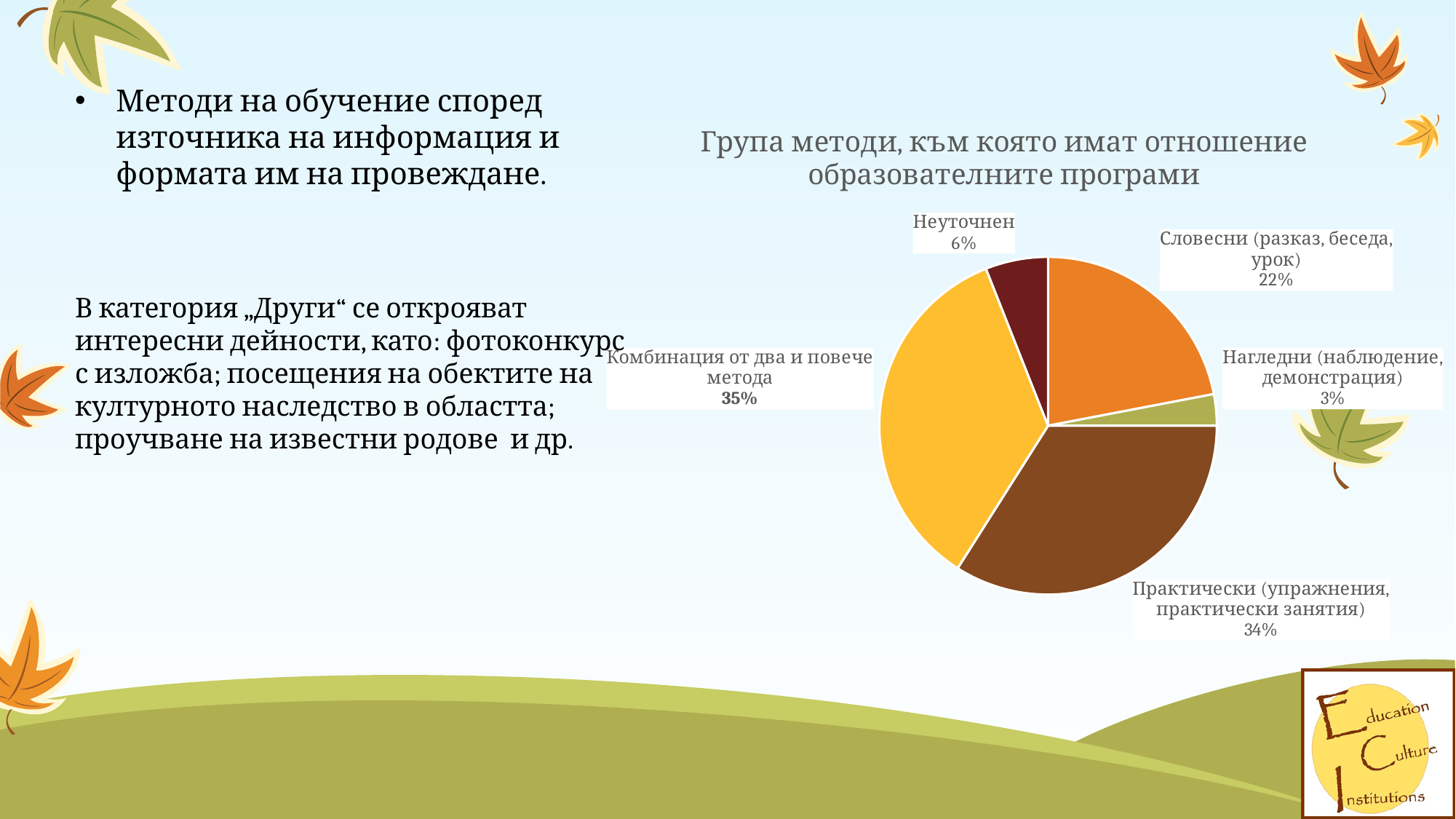
How many slices does the pie chart have? 5 What is the title of the chart? Група методи, към която имат отношение образователните програми What share of the pie is "Комбинация от два и повече метода"? 35% What share of the pie is "Нагледни (наблюдение, демонстрация)"? 3% What share of the pie is "Практически (упражнения, практически занятия)"? 34% Which category has the smallest share of the pie? Нагледни (наблюдение, демонстрация) Which is larger: the share for "Словесни (разказ, беседа, урок)" or the share for "Нагледни (наблюдение, демонстрация)"? Словесни (разказ, беседа, урок) Which category has the largest share of the pie? Комбинация от два и повече метода What type of chart is shown on the slide? Pie chart What is the difference in percentage points between "Словесни (разказ, беседа, урок)" and "Неуточнен"? 16